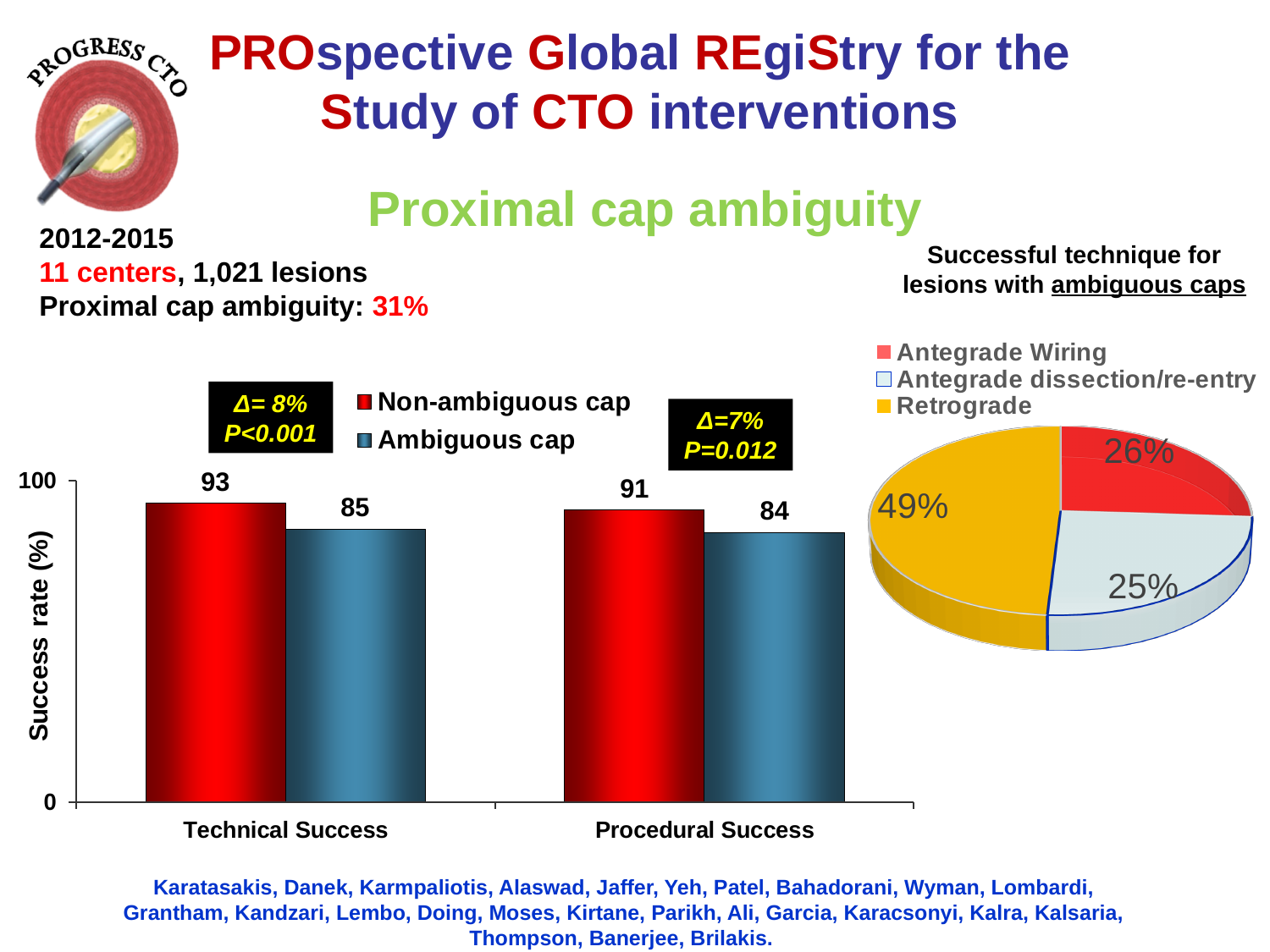
In the bar chart on the left, what is the label of the y axis? Success rate (%) In the pie chart titled 'Successful technique for lesions with ambiguous caps', how many slices are there? 3 In the bar chart on the left, how many series does the legend list? 2 In the bar chart on the left, what is the difference between the Non-ambiguous cap and Ambiguous cap values for Technical Success? 8 In the pie chart titled 'Successful technique for lesions with ambiguous caps', what share does Retrograde have? 49% In the pie chart titled 'Successful technique for lesions with ambiguous caps', which technique has the largest slice? Retrograde In the bar chart on the left, how many categories are shown on the x axis? 2 In the bar chart on the left, what is the technical success rate for the Non-ambiguous cap group? 93 In the bar chart on the left, what is the procedural success rate for the Ambiguous cap group? 84 In the bar chart on the left, which group has the higher procedural success rate, Non-ambiguous cap or Ambiguous cap? Non-ambiguous cap In the pie chart titled 'Successful technique for lesions with ambiguous caps', what share does Antegrade Wiring have? 26% What kind of chart is the chart on the left of the slide? Bar chart